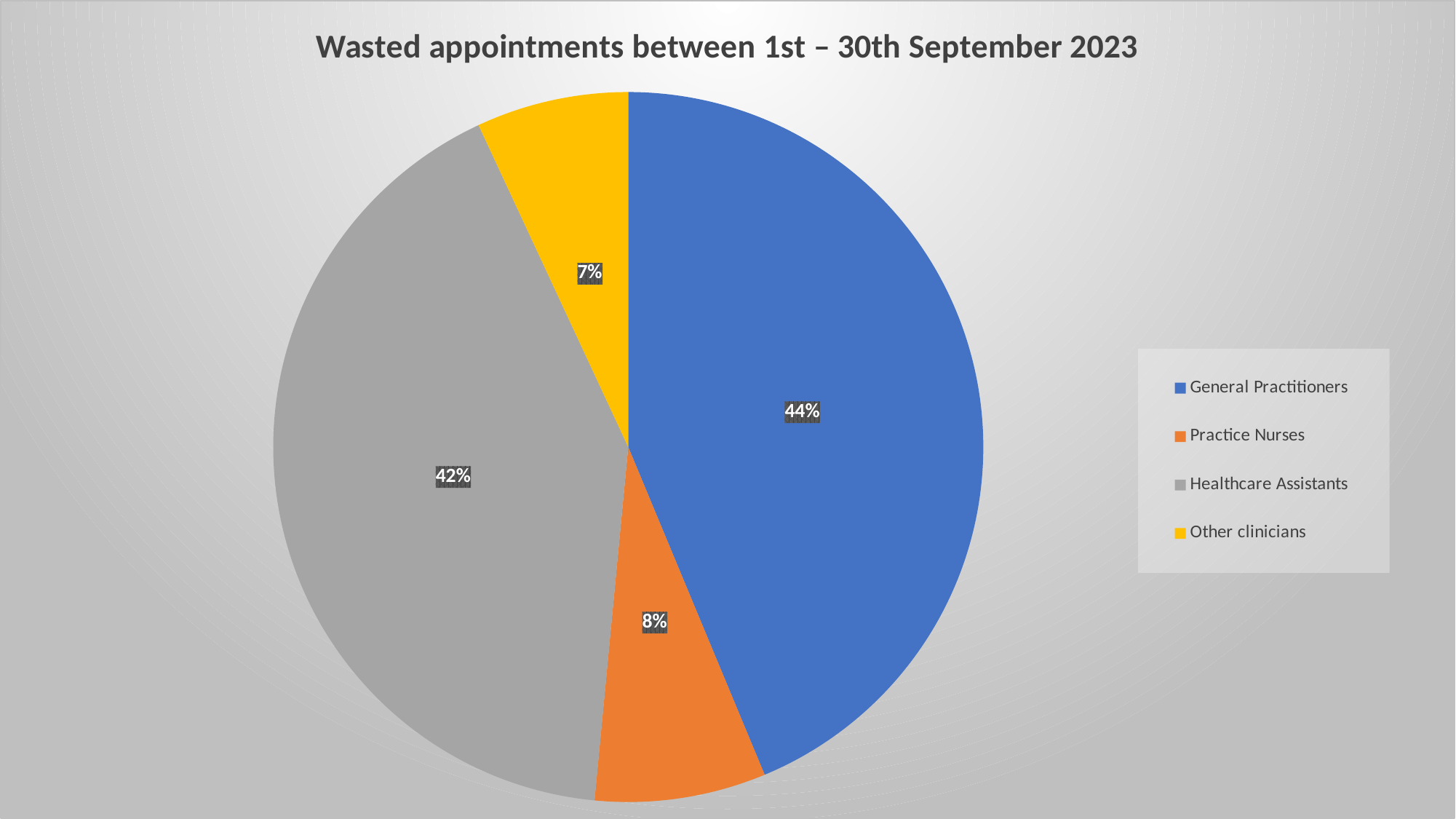
What is the difference in percentage points between the General Practitioners and Healthcare Assistants slices? 2 What share of wasted appointments is attributed to Healthcare Assistants? 42% Which category has the smallest share of wasted appointments? Other clinicians What kind of chart is shown on the slide? Pie chart What is the title of the chart? Wasted appointments between 1st – 30th September 2023 What share of wasted appointments is attributed to General Practitioners? 44% How many categories does the pie chart show? 4 Which is larger, the share for Practice Nurses or the share for Other clinicians? Practice Nurses What share of wasted appointments is attributed to Other clinicians? 7% What is the difference in percentage points between the Practice Nurses and Other clinicians slices? 1 Which category has the largest share of wasted appointments? General Practitioners